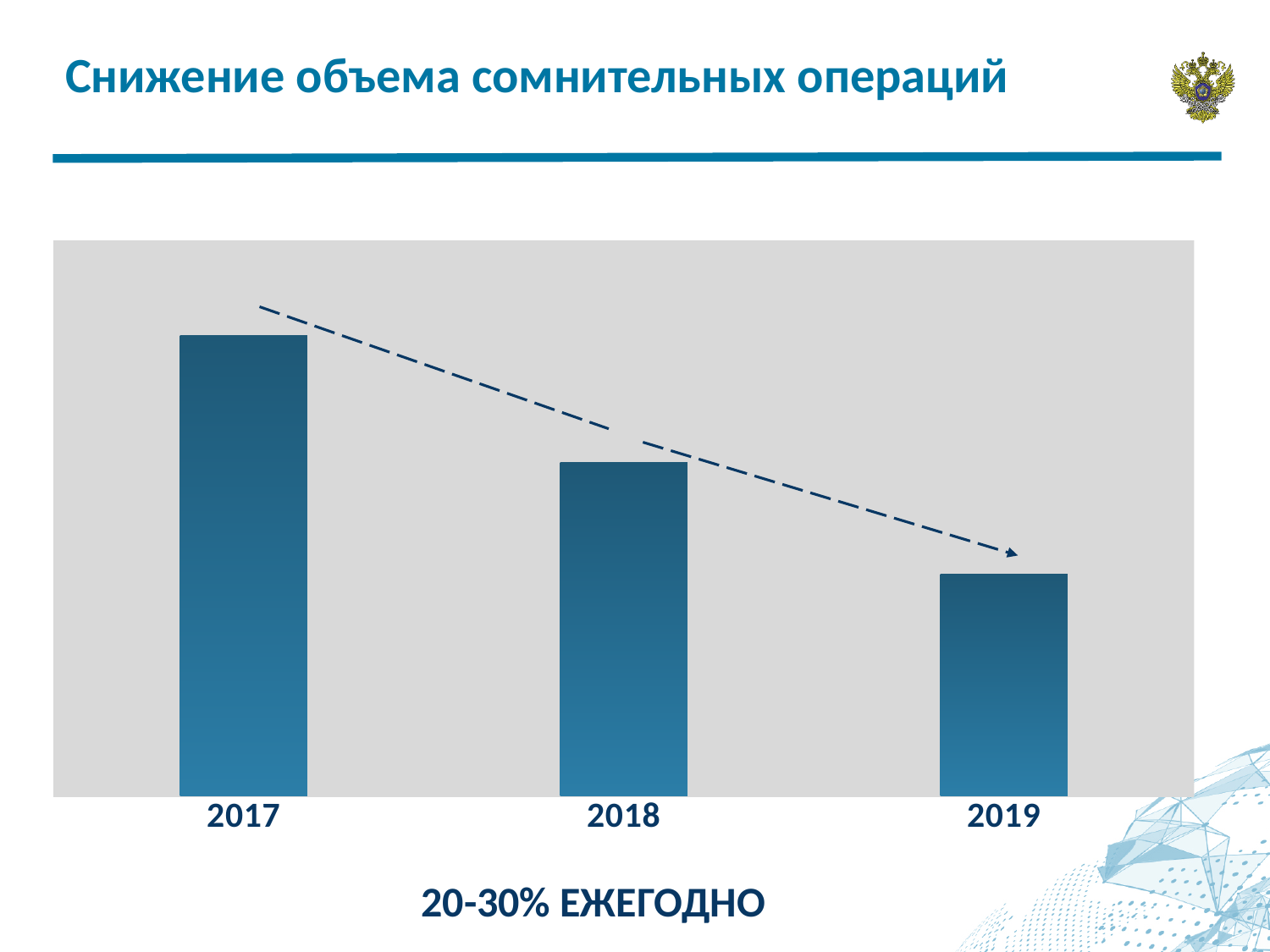
What is the last year shown on the x axis of the chart? 2019 Which bar is taller, 2017 or 2018? 2017 Which year has the lowest bar in the chart? 2019 What is the first year shown on the x axis of the chart? 2017 What annual rate of decrease is stated in the caption below the chart? 20-30% ЕЖЕГОДНО How many bars (years) are plotted in the chart? 3 What kind of chart is shown on the slide? Bar chart Do the bar values rise or fall from 2017 to 2019? Fall What is the title of the slide containing the chart? Снижение объема сомнительных операций Which year has the highest bar in the chart? 2017 Which bar is taller, 2018 or 2019? 2018